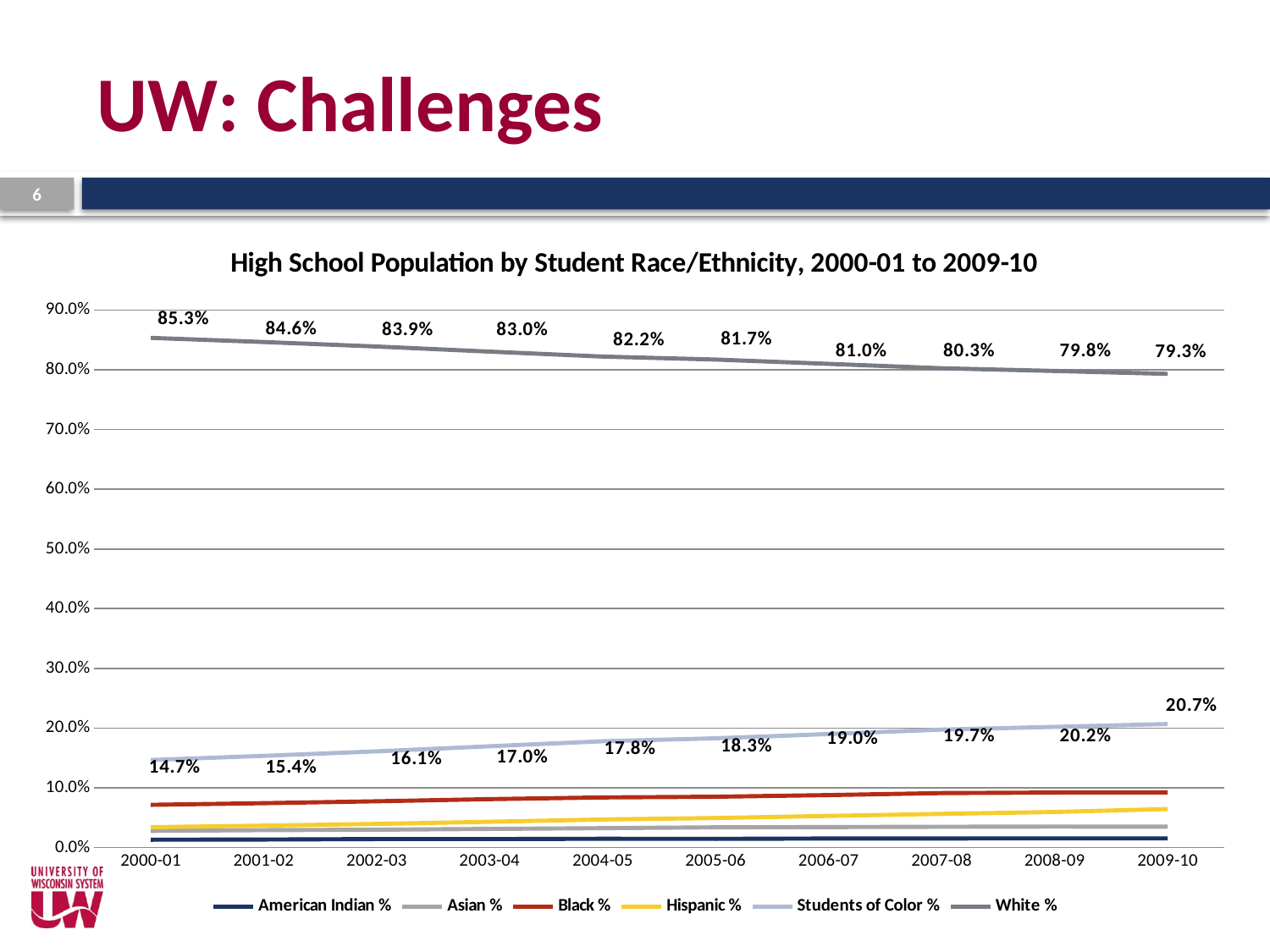
What is the White % value for 2000-01? 85.3% By how many percentage points did White % decrease from 2000-01 to 2009-10? 6.0 percentage points What is the White % value for 2005-06? 81.7% What is the Students of Color % value for 2009-10? 20.7% Which series has the highest values across all years? White % Does the Students of Color % series rise or fall from 2000-01 to 2009-10? rise Does the White % series rise or fall from 2000-01 to 2009-10? fall What kind of chart is shown on the slide? line chart What is the Students of Color % value for 2003-04? 17.0% How many school years are shown on the x axis? 10 Is the Black % value for 2009-10 greater or less than 10.0%? less How many series does the legend list? 6